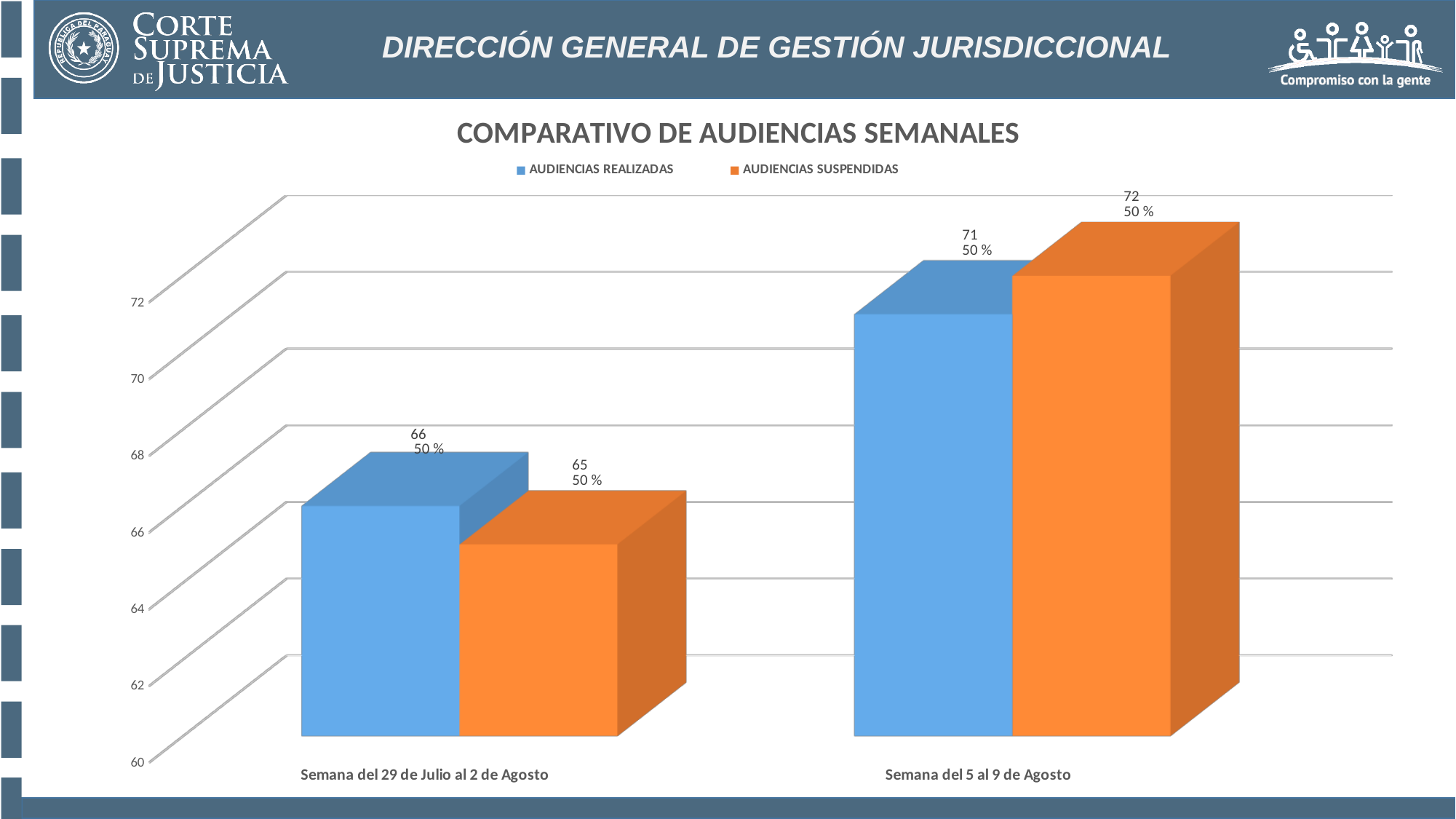
What is the value of AUDIENCIAS SUSPENDIDAS for Semana del 29 de Julio al 2 de Agosto? 65 What is the title of the chart? COMPARATIVO DE AUDIENCIAS SEMANALES What is the value of AUDIENCIAS REALIZADAS for Semana del 29 de Julio al 2 de Agosto? 66 What is the value of AUDIENCIAS SUSPENDIDAS for Semana del 5 al 9 de Agosto? 72 How many weeks (categories) are shown on the x axis? 2 How many series does the legend list? 2 Which week has the higher value for AUDIENCIAS REALIZADAS? Semana del 5 al 9 de Agosto What is the difference between AUDIENCIAS REALIZADAS in Semana del 5 al 9 de Agosto and Semana del 29 de Julio al 2 de Agosto? 5 What is the value of AUDIENCIAS REALIZADAS for Semana del 5 al 9 de Agosto? 71 What kind of chart is shown on the slide? Bar chart Which week has the lower value for AUDIENCIAS SUSPENDIDAS? Semana del 29 de Julio al 2 de Agosto What is the difference between AUDIENCIAS SUSPENDIDAS and AUDIENCIAS REALIZADAS in Semana del 5 al 9 de Agosto? 1